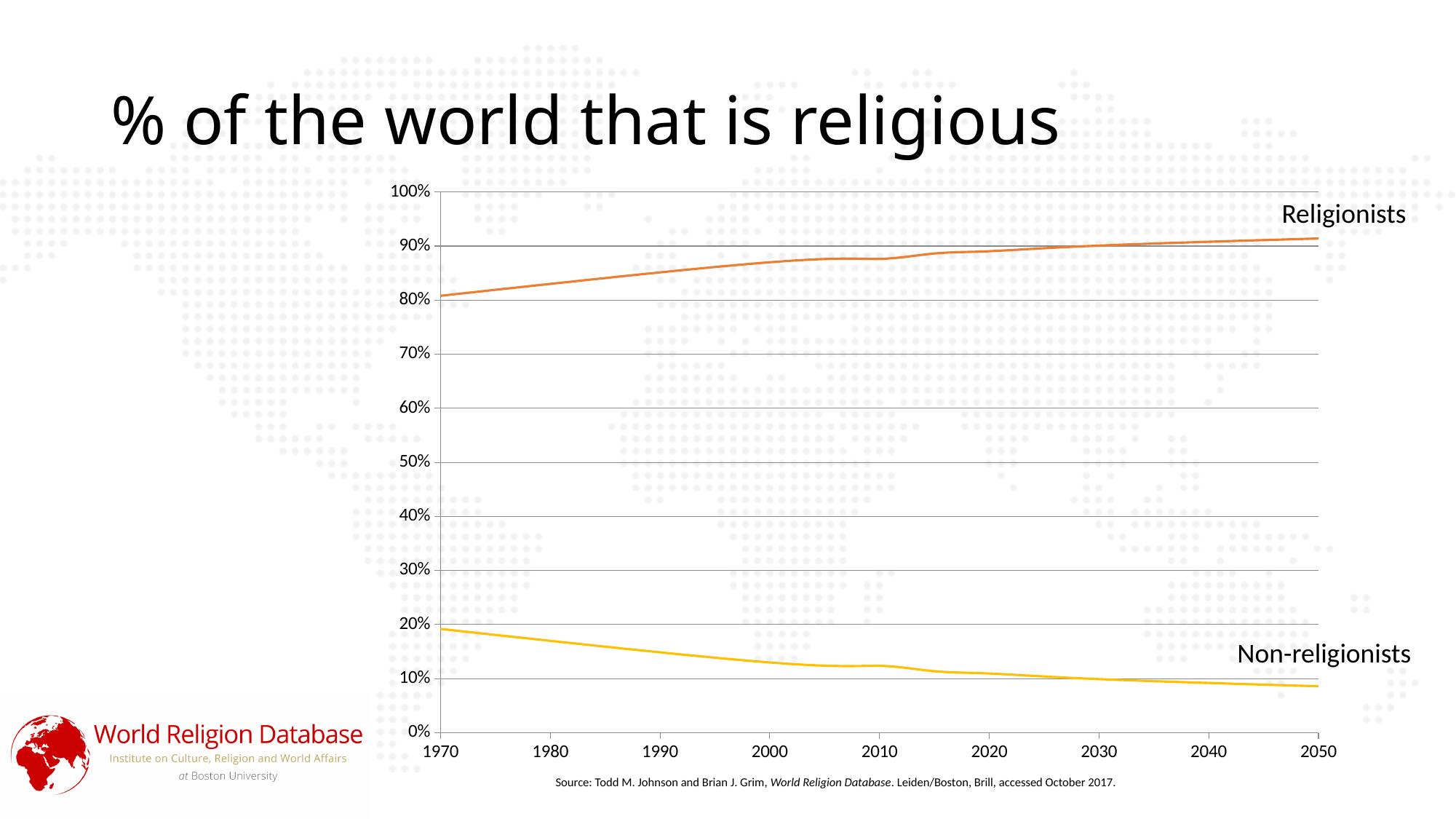
Does the Non-religionists line rise or fall from 1970 to 2050? fall Is the value for Religionists in 2020 greater or less than 70%? greater Which series has the higher value in 2050, Religionists or Non-religionists? Religionists What is the title of the chart on the slide? % of the world that is religious How many series are plotted on the chart? 2 Which series is drawn in yellow? Non-religionists How many year labels are shown on the x axis? 9 Is the value for Non-religionists in 2050 greater or less than 10%? less Is the value for Religionists in 2000 greater or less than 80%? greater What kind of chart is shown on the slide? line chart Does the Religionists line rise or fall from 1970 to 2050? rise